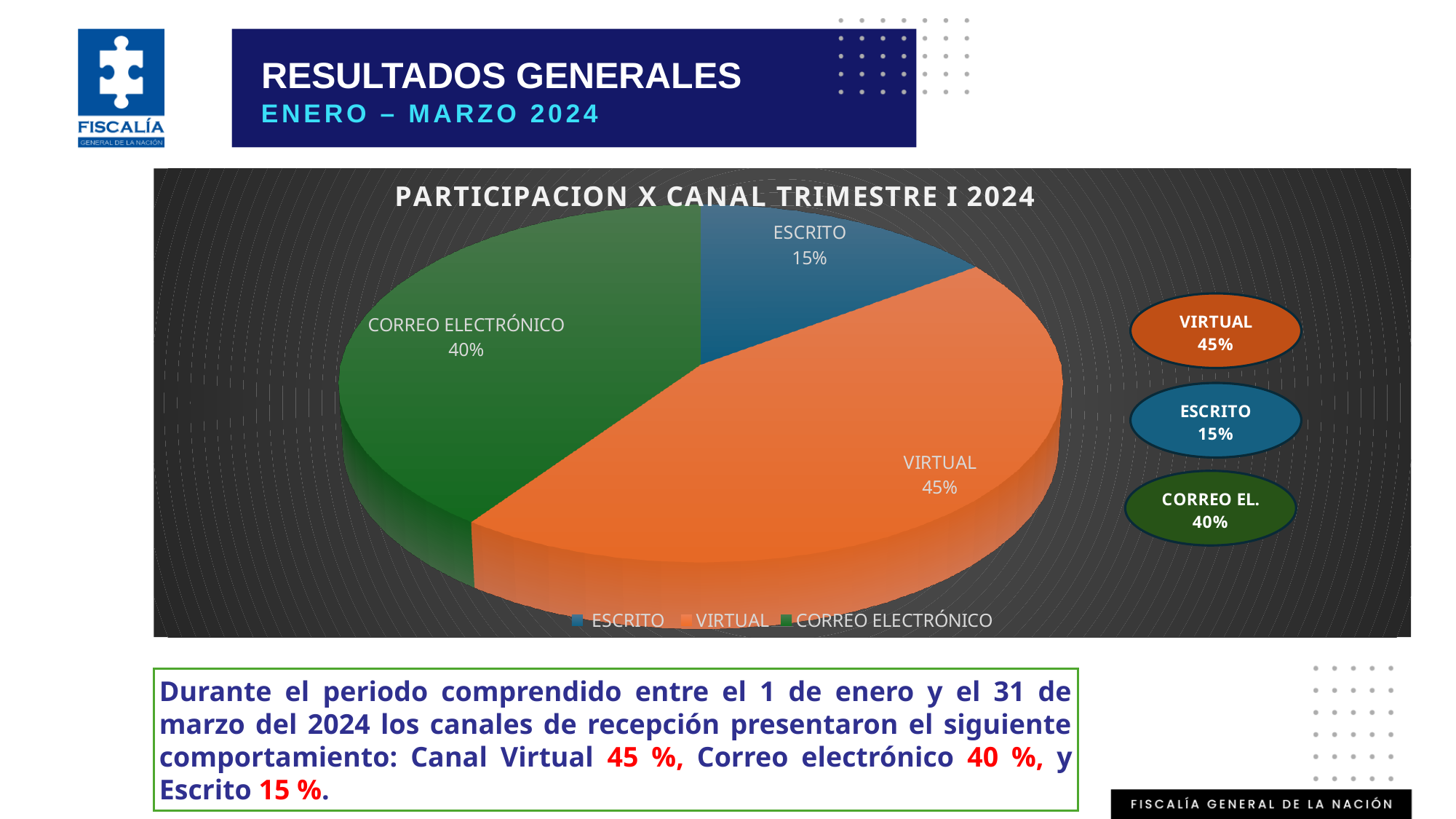
What share of the pie does VIRTUAL represent? 45% What is the difference in percentage points between VIRTUAL and ESCRITO? 30 What is the title of the chart? PARTICIPACION X CANAL TRIMESTRE I 2024 What share of the pie does CORREO ELECTRÓNICO represent? 40% How many slices does the pie chart have? 3 What type of chart is shown on the slide? Pie chart What is the difference in percentage points between VIRTUAL and CORREO ELECTRÓNICO? 5 Which channel has the smallest share of the pie? ESCRITO Which is larger, the share for CORREO ELECTRÓNICO or the share for ESCRITO? CORREO ELECTRÓNICO Which channel has the largest share of the pie? VIRTUAL What share of the pie does ESCRITO represent? 15% How many entries does the legend list? 3